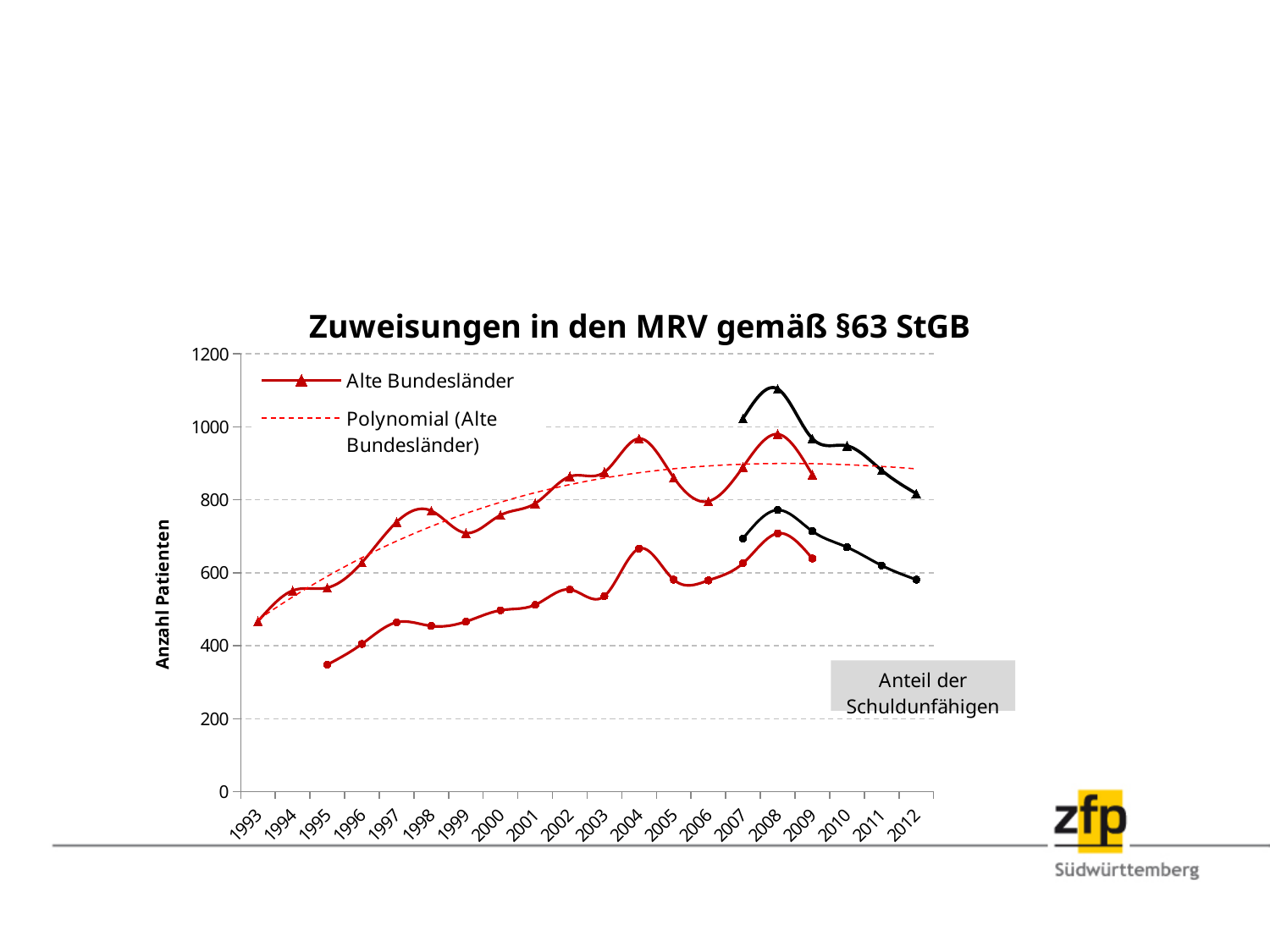
How many years are shown on the x axis? 20 What is the title of the chart? Zuweisungen in den MRV gemäß §63 StGB Is the value for Alte Bundesländer in 2004 greater or less than 800? greater In which year is the Alte Bundesländer series at its lowest? 1993 Is the value for Alte Bundesländer in 1993 greater or less than 600? less Does the Alte Bundesländer series rise or fall from 1993 to 1997? rise Is the value for Alte Bundesländer in 1997 greater or less than 600? greater How many series does the legend list? 2 Which is larger for Alte Bundesländer, the value in 1993 or the value in 2004? 2004 What kind of chart is shown on the slide? line chart What is the label of the vertical axis? Anzahl Patienten